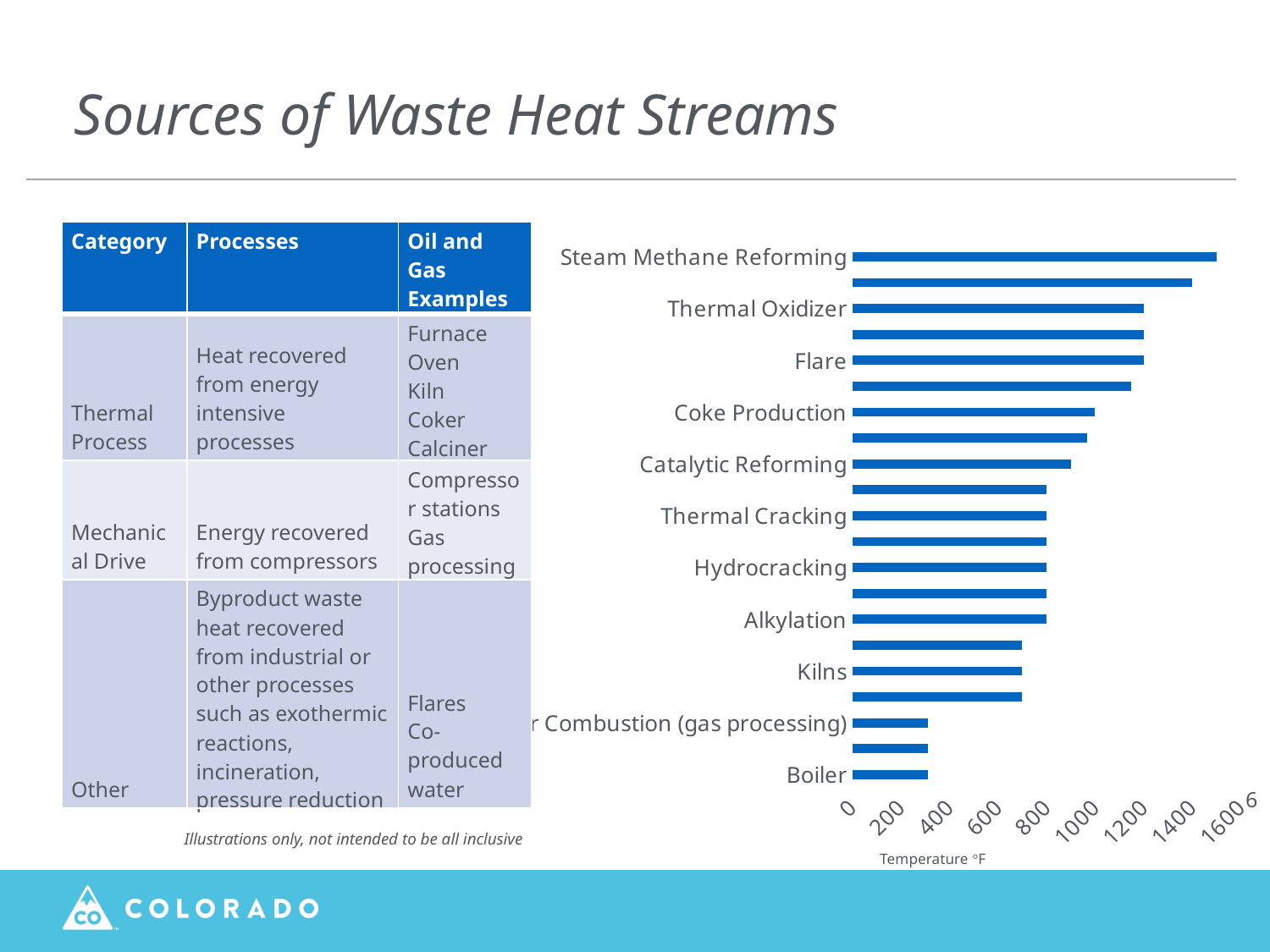
Which has a lower temperature value, Steam Methane Reforming or Boiler? Boiler Is the top bar for Catalytic Reforming greater or less than 1200? less Is the top bar for Coke Production greater or less than 800? greater Which category has the highest temperature value in the chart? Steam Methane Reforming Is the top bar for Kilns greater or less than 1000? less Which has a higher temperature value, Flare or Kilns? Flare How many categories are listed on the vertical axis of the chart? 11 What kind of chart is shown on the slide? bar chart What is the label of the horizontal axis of the chart? Temperature °F